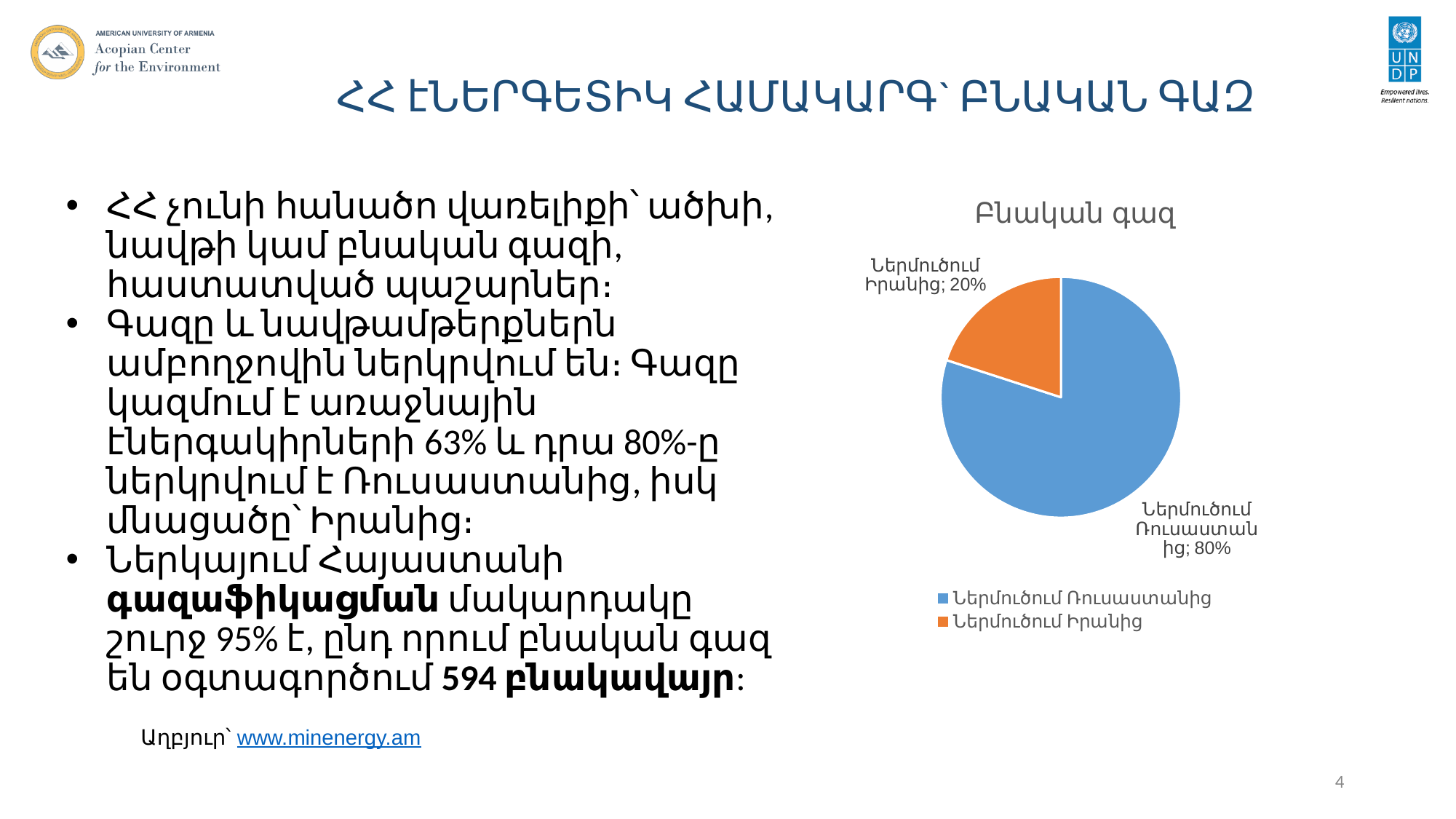
Which slice of the pie is the largest? Ներմուծում Ռուսաստանից How many entries does the legend list? 2 Which slice of the pie is the smallest? Ներմուծում Իրանից What share of the pie is labelled Ներմուծում Իրանից? 20% What is the difference in percentage points between the Ներմուծում Ռուսաստանից slice and the Ներմուծում Իրանից slice? 60% What share of the pie is labelled Ներմուծում Ռուսաստանից? 80% Which is larger: the Ներմուծում Իրանից slice or the Ներմուծում Ռուսաստանից slice? Ներմուծում Ռուսաստանից What kind of chart is shown on the slide? Pie chart How many slices does the pie chart have? 2 What is the title of the chart? Բնական գազ What is the total of the two slices shown in the pie chart? 100% What colour is the Ներմուծում Իրանից slice? Orange